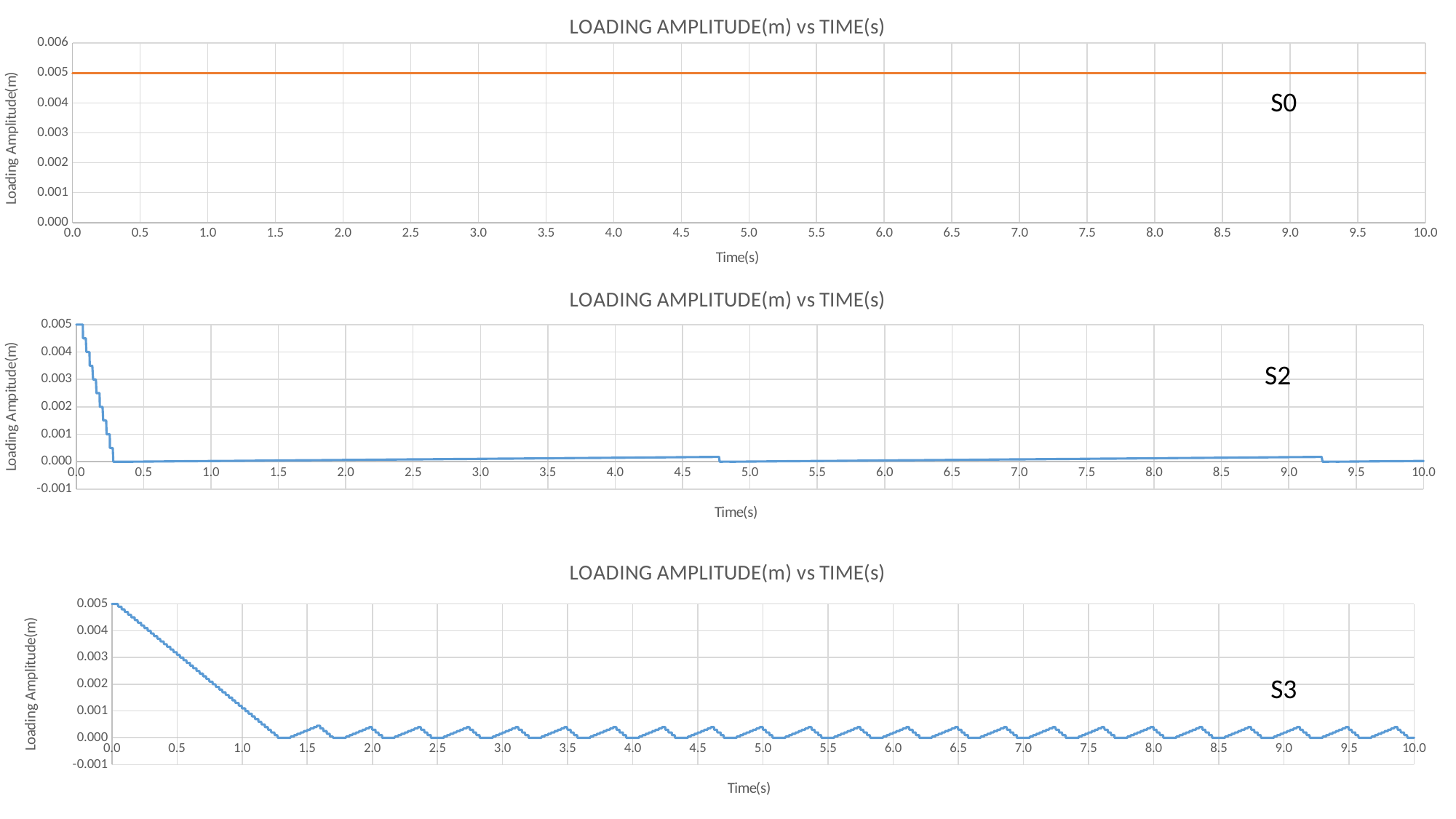
In the top chart (S0), does the loading amplitude rise, fall, or stay flat as time increases? stays flat In the bottom chart (S3), what is the loading amplitude at time 0.0 s? 0.005 How many charts are shown on the slide? 3 What kind of chart is the top chart labelled S0? line chart In the top chart (S0), is the value at 5.0 s greater or less than 0.004? greater In the top chart (S0), what is the constant loading amplitude value of the line? 0.005 In the middle chart (S2), is the value at 5.0 s greater or less than 0.001? less In the middle chart (S2), what is the loading amplitude at time 0.0 s? 0.005 What is the title of the bottom chart (S3)? LOADING AMPLITUDE(m) vs TIME(s) In the bottom chart (S3), is the value at 0.5 s greater or less than 0.002? greater In the middle chart (S2), does the loading amplitude rise or fall between 0.0 s and 0.5 s? fall